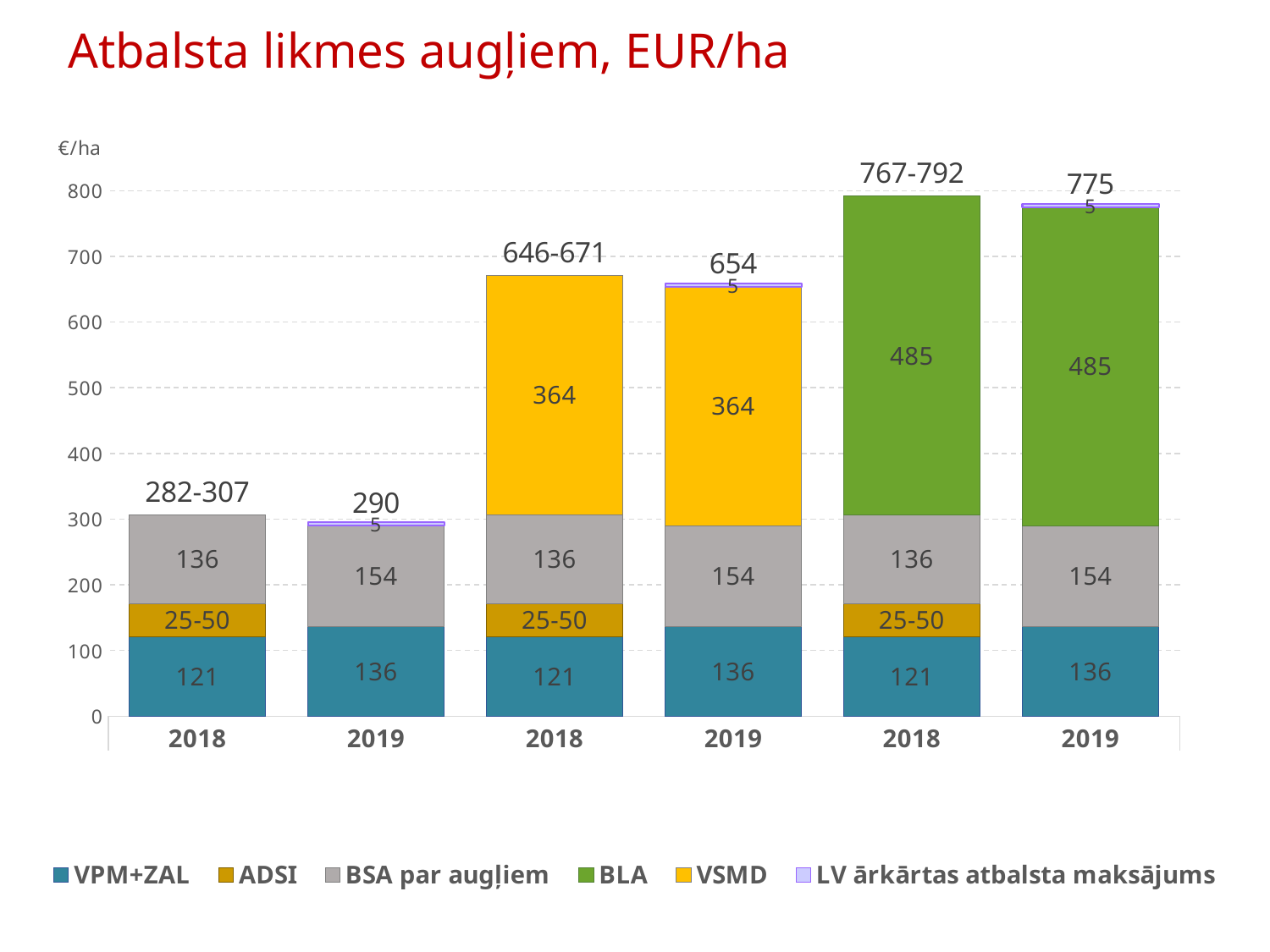
How many series does the legend list? 6 What kind of chart is shown on the slide? Stacked bar chart What is the difference between the BSA par augļiem value in the 2019 bars (154) and in the 2018 bars (136)? 18 What is the BLA value in the last (rightmost) 2019 bar? 485 What is the LV ārkārtas atbalsta maksājums value in the rightmost 2019 bar? 5 What is the BSA par augļiem value in the second bar (2019, total 290)? 154 What is the VSMD value in the fourth bar (2019, total 654)? 364 Which is larger, the BSA par augļiem value in the first 2018 bar or in the second 2019 bar? 2019 bar (154) What total is labelled above the third bar (2018 with VSMD)? 646-671 What is the VPM+ZAL value in the first (leftmost) 2018 bar? 121 How many bars are plotted in the chart? 6 What total is labelled above the rightmost 2019 bar? 775